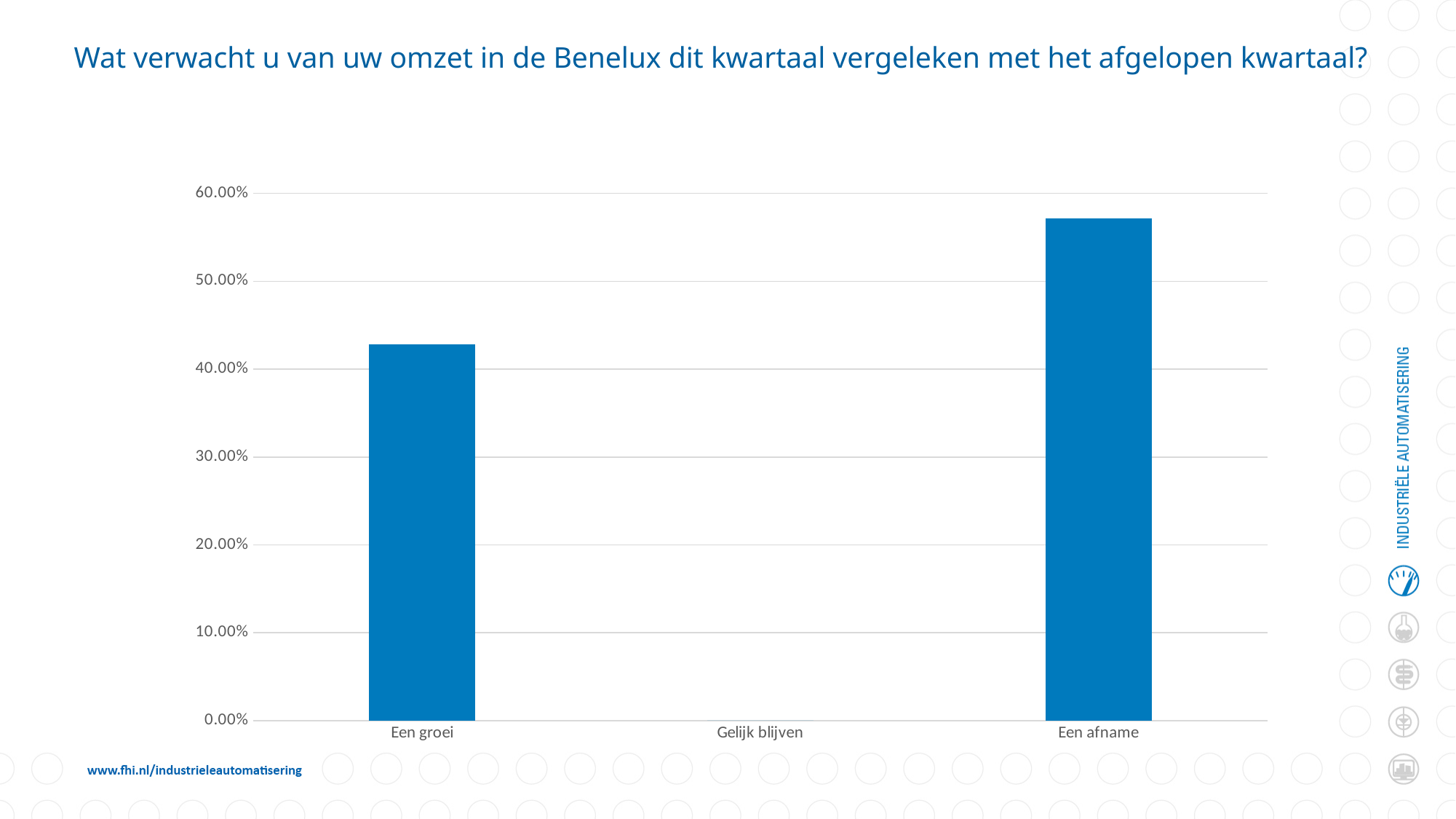
Is the value for Een afname greater or less than 50.00%? greater What is the title of the chart on the slide? Wat verwacht u van uw omzet in de Benelux dit kwartaal vergeleken met het afgelopen kwartaal? How many categories are shown on the x axis of the chart? 3 Is the value for Een afname greater or less than 60.00%? less Is the value for Gelijk blijven greater or less than 10.00%? less What colour are the bars in the chart? blue Which of the two has the larger value, Een groei or Een afname? Een afname Which category has the highest value in the chart? Een afname What kind of chart is shown on the slide? bar chart Which category has the lowest value in the chart? Gelijk blijven